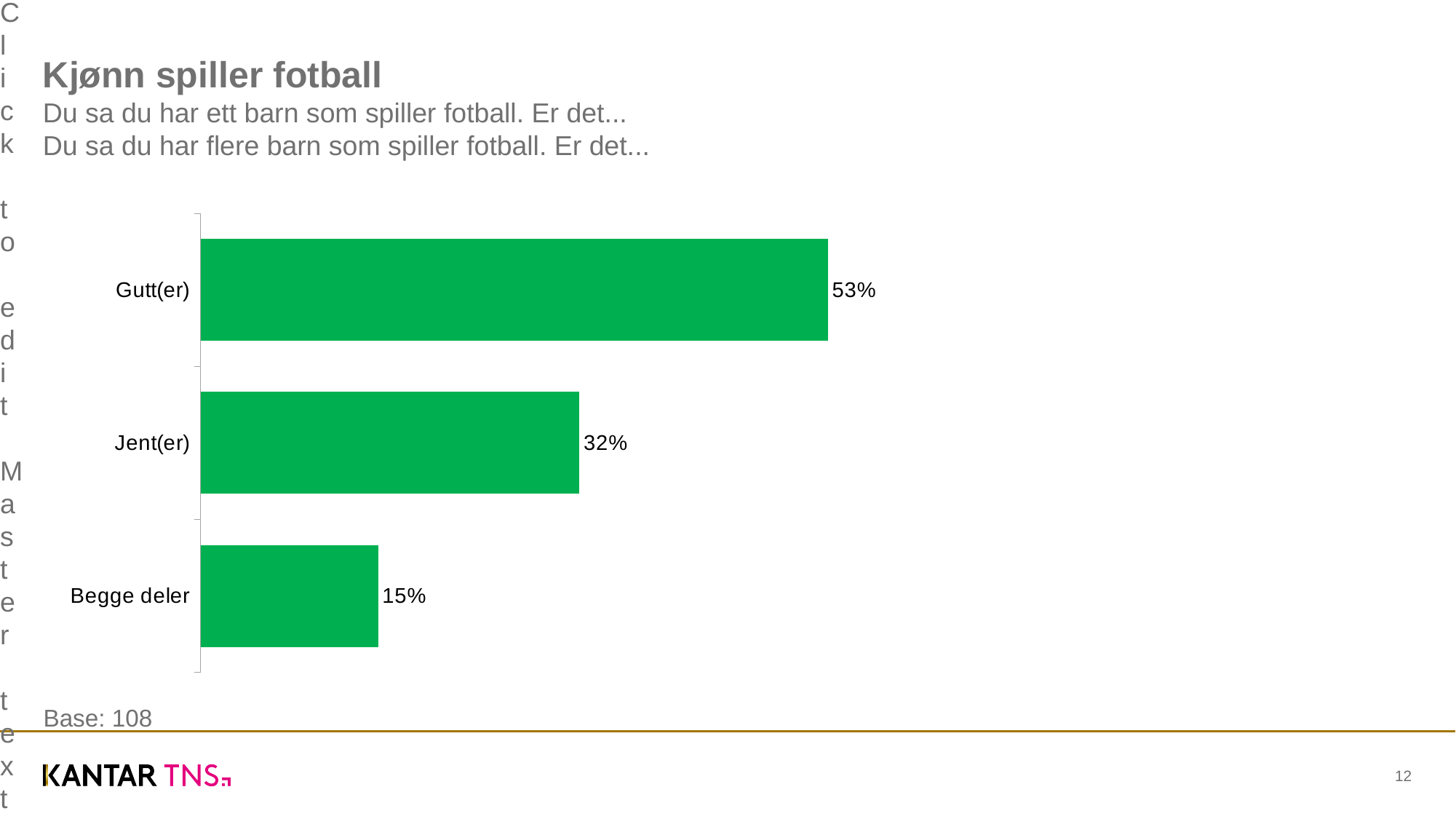
What is the title of the slide? Kjønn spiller fotball Which is larger, the value for Jent(er) or the value for Begge deler? Jent(er) What is the difference between the values for Gutt(er) and Jent(er)? 21% What is the base (number of respondents) stated on the slide? 108 Which category has the highest value? Gutt(er) Which category has the lowest value? Begge deler What is the value for Gutt(er)? 53% What kind of chart is shown on the slide? Bar chart What is the value for Begge deler? 15% How many categories are shown in the chart? 3 What is the value for Jent(er)? 32% What is the difference between the values for Jent(er) and Begge deler? 17%